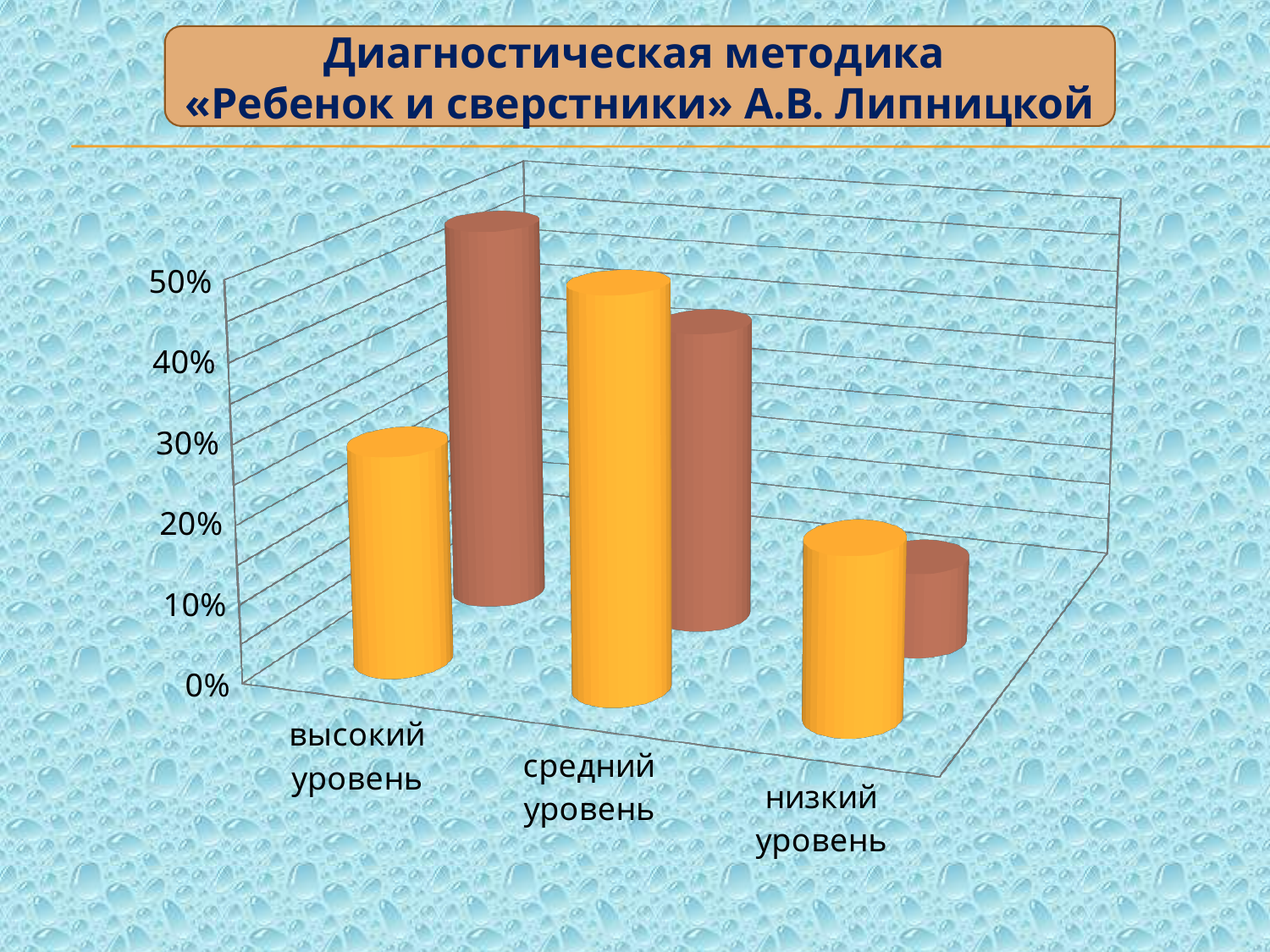
Among the yellow bars, which category has the lowest value? низкий уровень What is the title of the slide above the chart? Диагностическая методика «Ребенок и сверстники» А.В. Липницкой For низкий уровень, which bar is larger, the yellow one or the brown one? yellow For высокий уровень, which bar is larger, the yellow one or the brown one? brown Is the value of the brown bar for низкий уровень greater or less than 20%? less What kind of chart is shown on the slide? bar chart Among the yellow bars, which category has the highest value? средний уровень How many categories are shown on the x axis of the chart? 3 Among the brown bars, which category has the lowest value? низкий уровень Among the brown bars, which category has the highest value? высокий уровень Is the value of the yellow bar for средний уровень greater or less than 40%? greater What are the three categories on the x axis of the chart? высокий уровень, средний уровень, низкий уровень